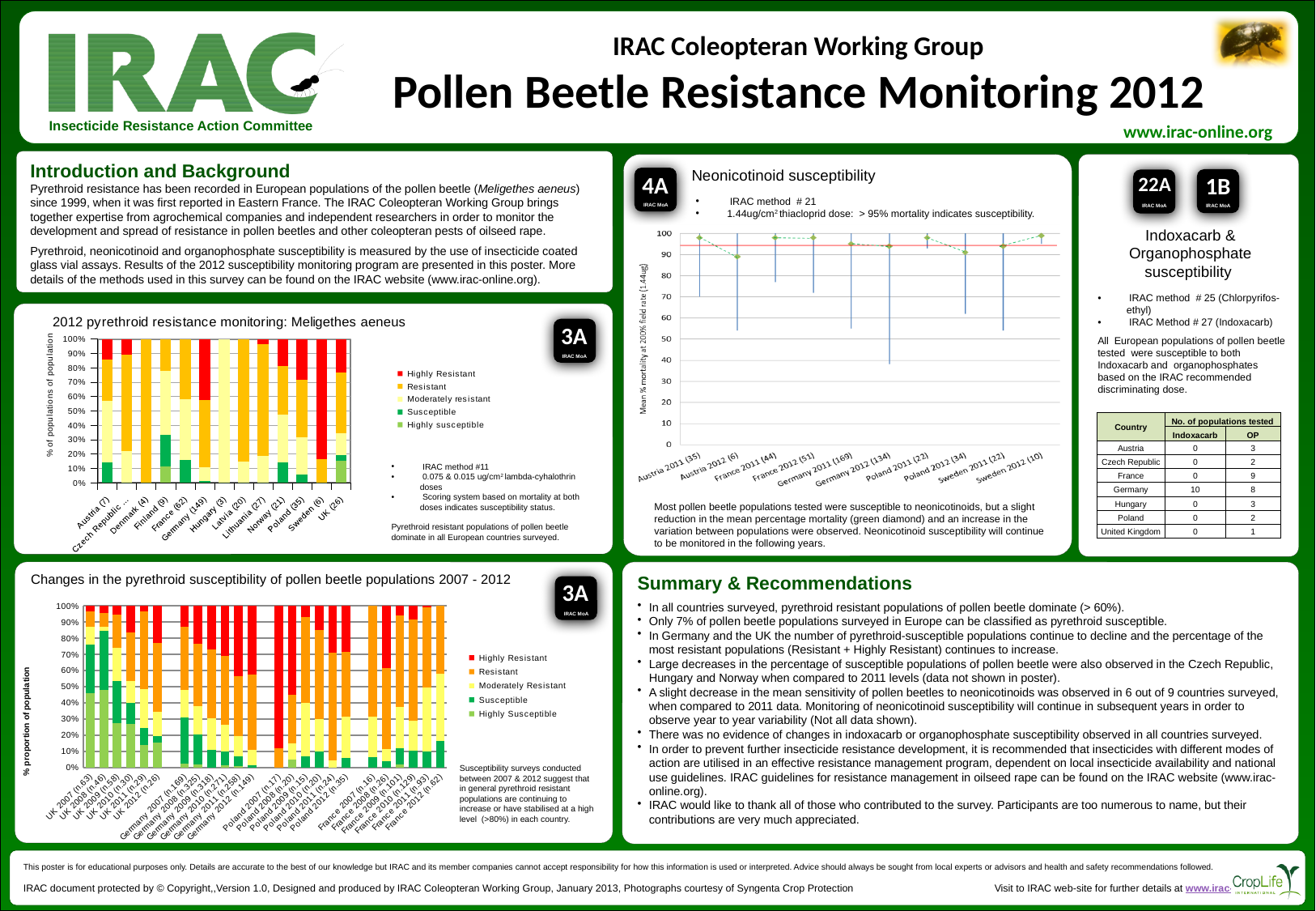
In the '2012 pyrethroid resistance monitoring: Meligethes aeneus' chart, is the Moderately resistant share for Latvia (20) greater or less than 90%? less What kind of chart is the '2012 pyrethroid resistance monitoring: Meligethes aeneus' chart? Bar chart In the 'Neonicotinoid susceptibility' chart, how many population points are plotted along the x axis? 10 In the 'Neonicotinoid susceptibility' chart, is the mean % mortality for Austria 2011 (35) greater or less than 90? greater How many series does the legend of the '2012 pyrethroid resistance monitoring: Meligethes aeneus' chart list? 5 In the 'Changes in the pyrethroid susceptibility of pollen beetle populations 2007 - 2012' chart, which colour represents the Highly Resistant series? Red In the '2012 pyrethroid resistance monitoring: Meligethes aeneus' chart, is the Highly Resistant share for Austria (7) greater or less than 20%? less In the 'Neonicotinoid susceptibility' chart, which population has the lowest mean % mortality? Austria 2012 (6) How many countries are shown on the x axis of the '2012 pyrethroid resistance monitoring: Meligethes aeneus' chart? 13 How many series does the legend of the 'Changes in the pyrethroid susceptibility of pollen beetle populations 2007 - 2012' chart list? 5